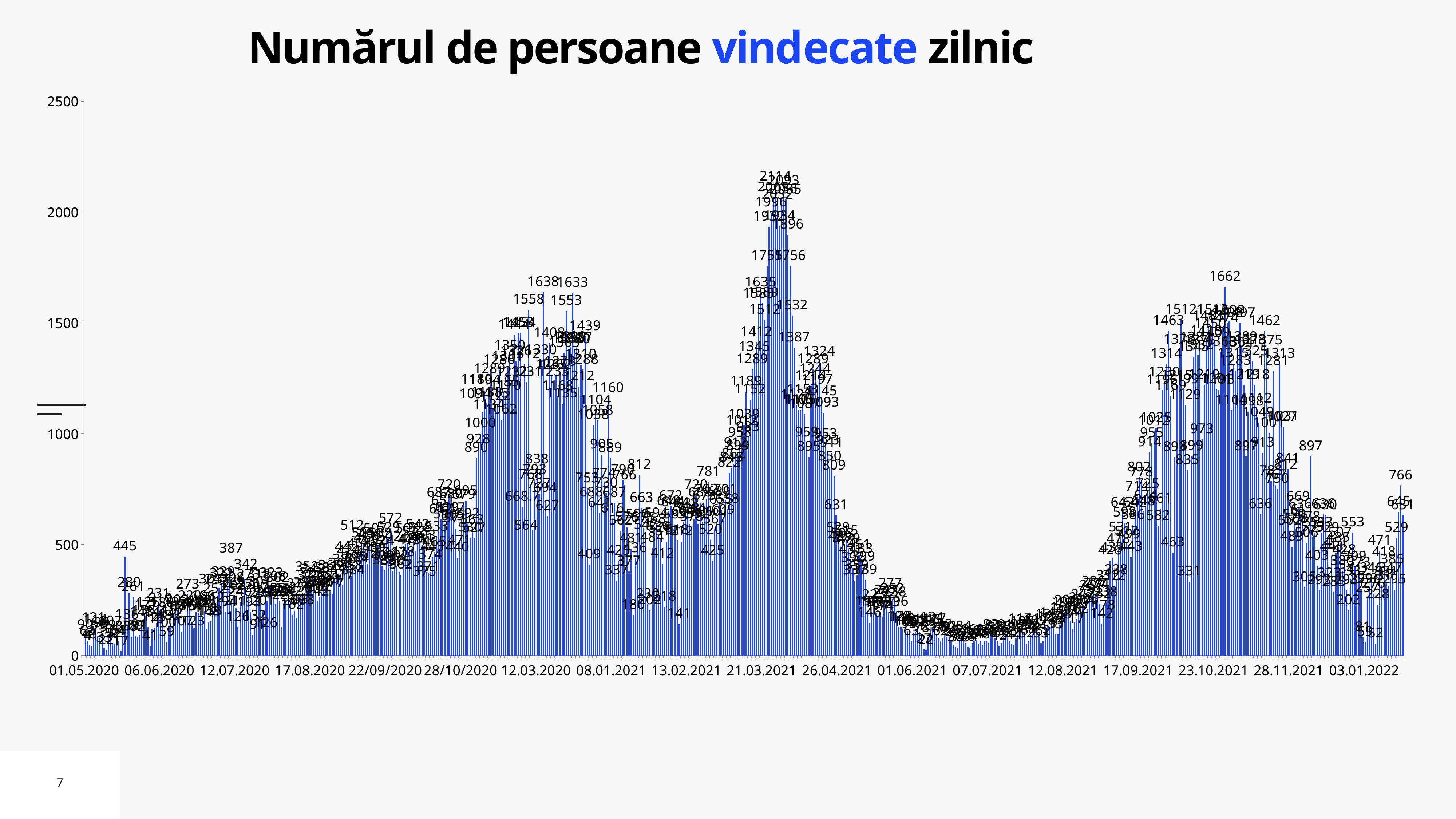
What is the title of the chart? Numărul de persoane vindecate zilnic What is the labelled peak value near 06.06.2020? 445 Do the values rise or fall between 01.06.2021 and 07.07.2021? fall What is the maximum value shown on the y axis? 2500 What is the highest labelled value in the wave around 23.10.2021? 1662 Is the highest value in the wave around 21.03.2021 greater or less than 2000? greater What kind of chart is shown on the slide? bar chart Which peak is higher: the one around 21.03.2021 or the one around 23.10.2021? the one around 21.03.2021 What is the difference between the peak value 2114 and the peak value 1662? 452 What is the highest daily value labelled on the chart? 2114 Are the daily values around 07.07.2021 greater or less than 500? less Do the values rise or fall between 12.08.2021 and 23.10.2021? rise